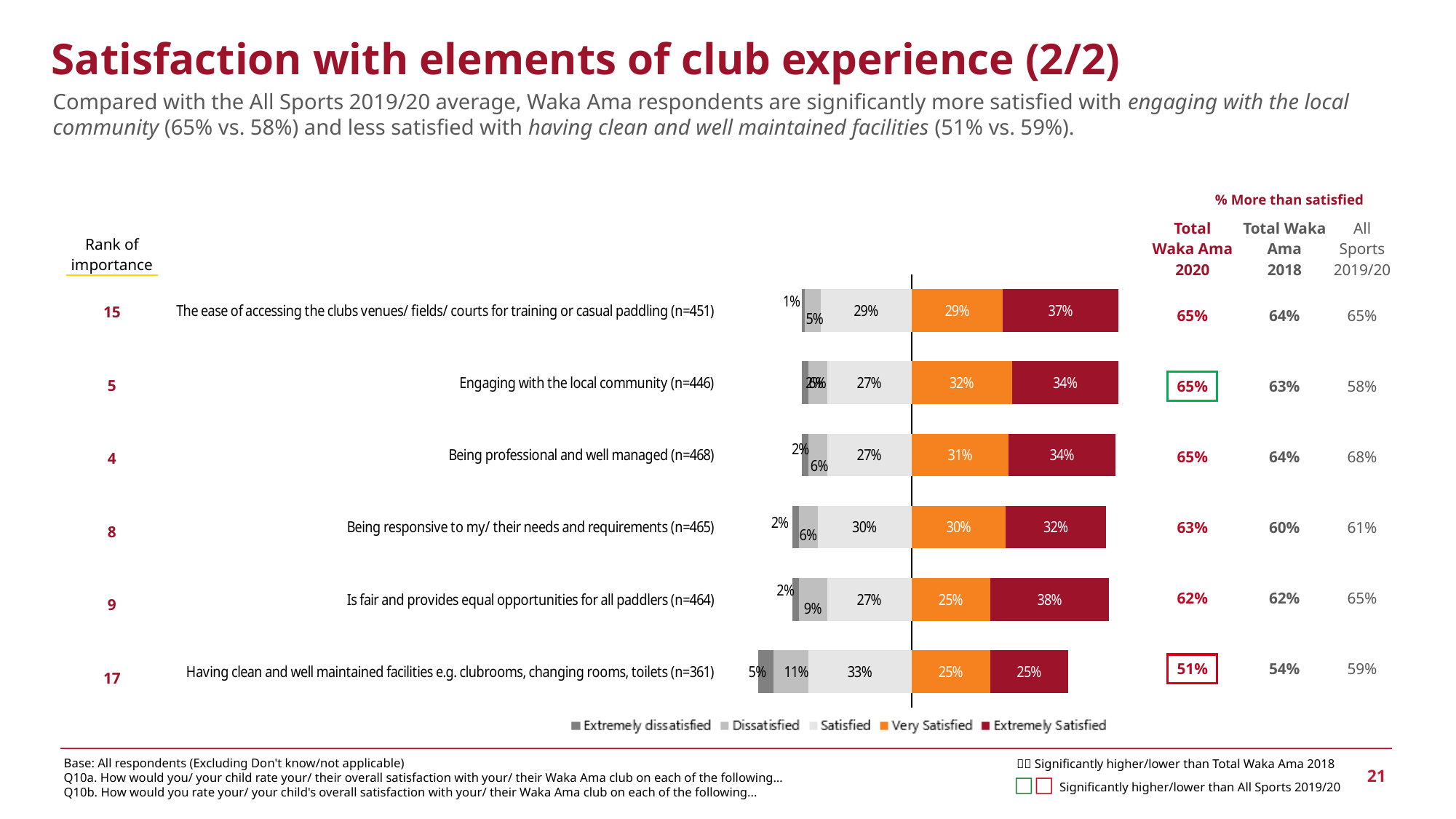
What is the difference in Extremely Satisfied percentage between 'The ease of accessing the clubs venues/ fields/ courts for training or casual paddling' and 'Having clean and well maintained facilities'? 12 percentage points Which category has the highest Extremely dissatisfied percentage? Having clean and well maintained facilities e.g. clubrooms, changing rooms, toilets What is the Satisfied value for 'Having clean and well maintained facilities e.g. clubrooms, changing rooms, toilets'? 33% What type of chart is shown on the slide? Stacked bar chart Which category has the lowest Extremely Satisfied percentage? Having clean and well maintained facilities e.g. clubrooms, changing rooms, toilets Which colour represents the Extremely Satisfied series in the chart? Dark red How many categories (club experience elements) are shown in the chart? 6 How many series does the chart legend list? 5 What is the Dissatisfied value for 'Is fair and provides equal opportunities for all paddlers'? 9% Which category has the highest Extremely Satisfied percentage? Is fair and provides equal opportunities for all paddlers What percentage of respondents are Extremely Satisfied with 'Is fair and provides equal opportunities for all paddlers'? 38% Which has a larger Very Satisfied percentage: 'Engaging with the local community' or 'Is fair and provides equal opportunities for all paddlers'? Engaging with the local community